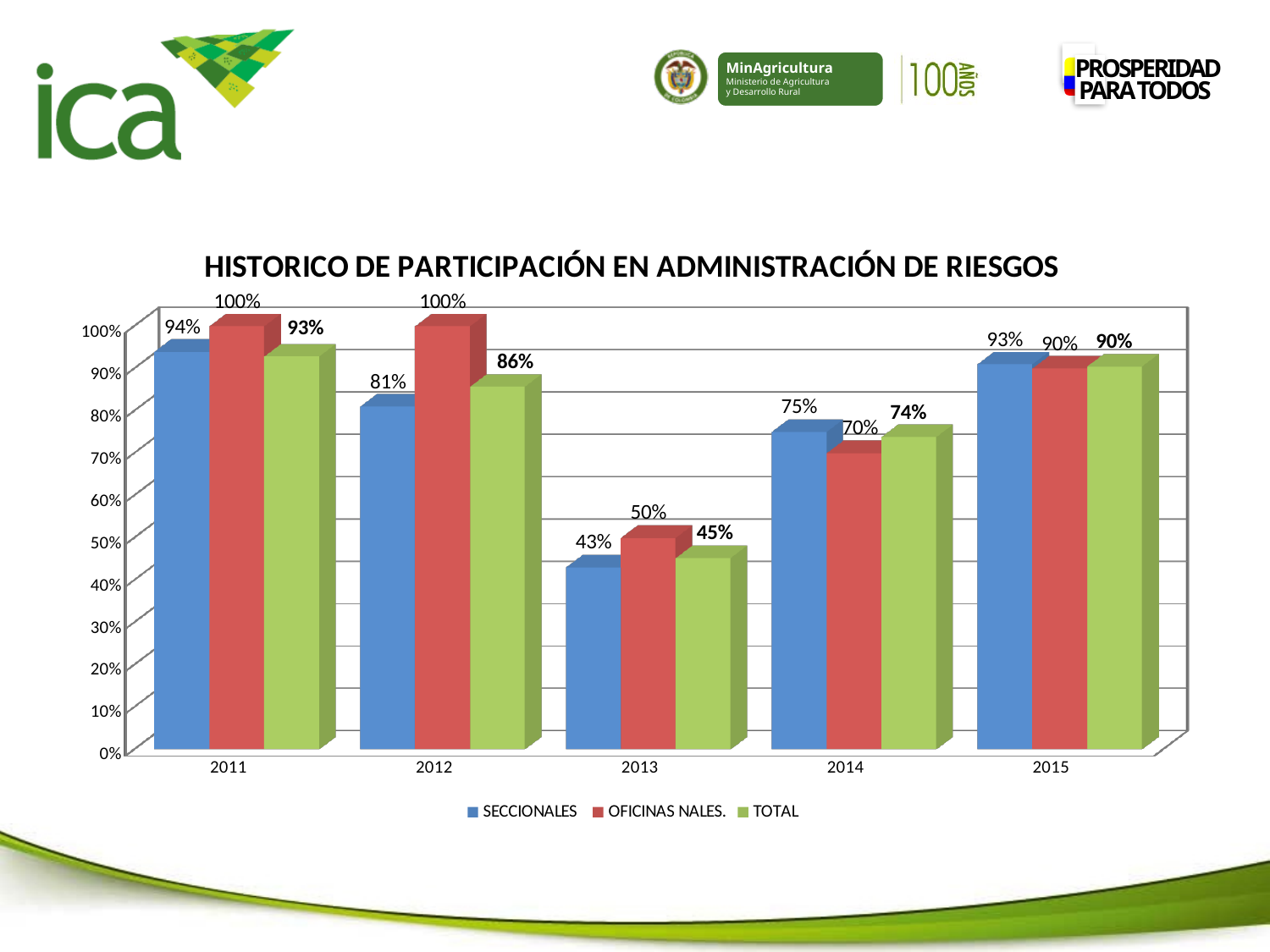
Which year has the lowest TOTAL value? 2013 What is the title of the chart? HISTORICO DE PARTICIPACIÓN EN ADMINISTRACIÓN DE RIESGOS What is the TOTAL value for 2013? 45% Which is larger in 2014, SECCIONALES or OFICINAS NALES.? SECCIONALES What is the value for SECCIONALES in 2011? 94% What kind of chart is shown on the slide? Bar chart How many years are shown on the x axis? 5 What is the value for OFICINAS NALES. in 2014? 70% In which years does OFICINAS NALES. reach its highest value of 100%? 2011 and 2012 How many series does the legend list? 3 Does the TOTAL value rise or fall from 2013 to 2015? Rise What is the difference between the SECCIONALES and OFICINAS NALES. values in 2012? 19%